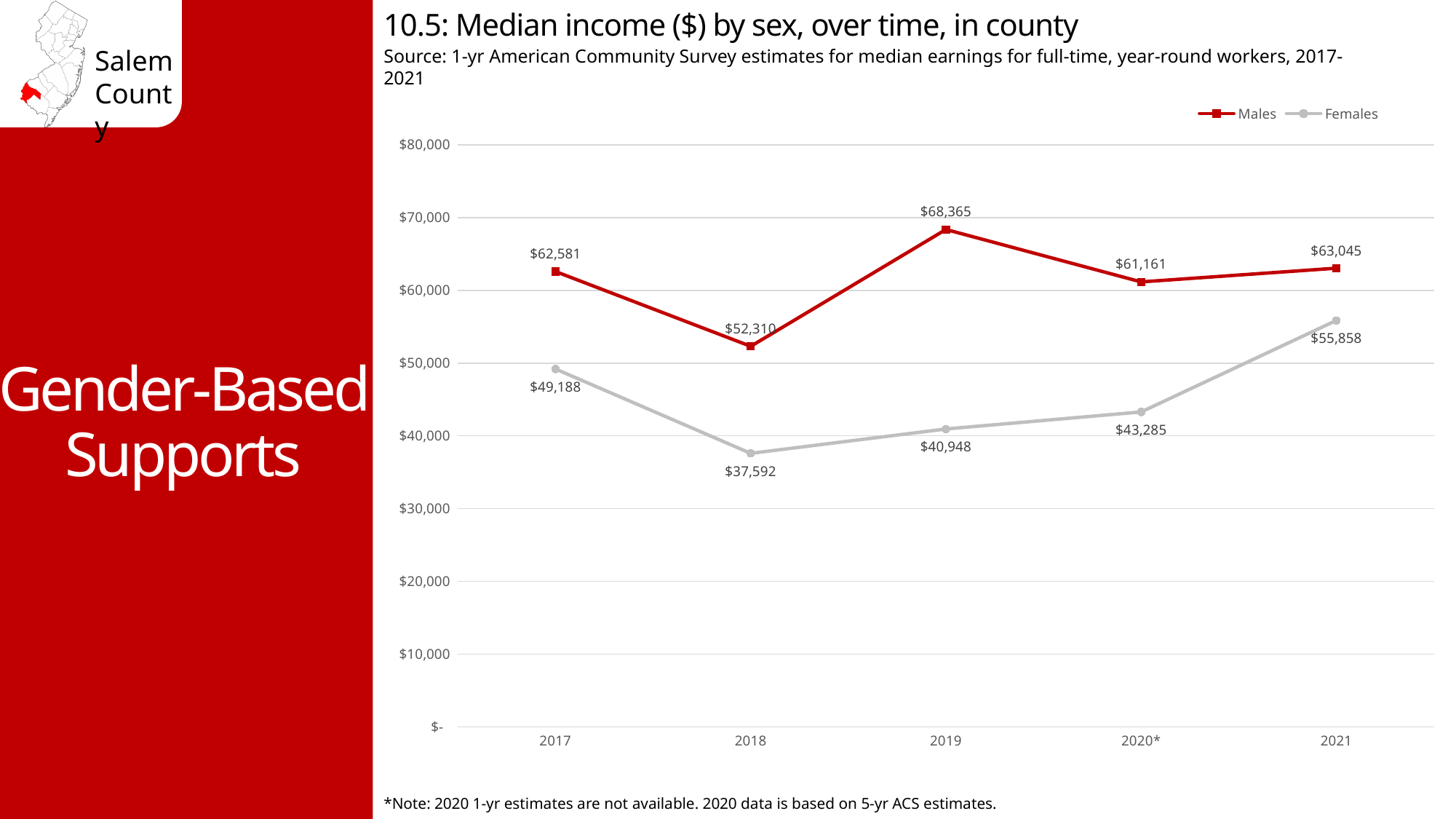
Which was larger in 2020*, the median income for Males or for Females? Males What was the median income for Females in 2021? $55,858 What is the difference between the Males and Females median income in 2017? $13,393 Did the median income for Females rise or fall from 2018 to 2021? rise In which year was the median income for Males highest? 2019 Is the median income for Females in 2020* greater or less than $50,000? less What kind of chart is shown on the slide? line chart What was the median income for Females in 2018? $37,592 How many series does the legend list? 2 In which year was the median income for Females lowest? 2018 How many years are shown on the x axis? 5 What was the median income for Males in 2019? $68,365